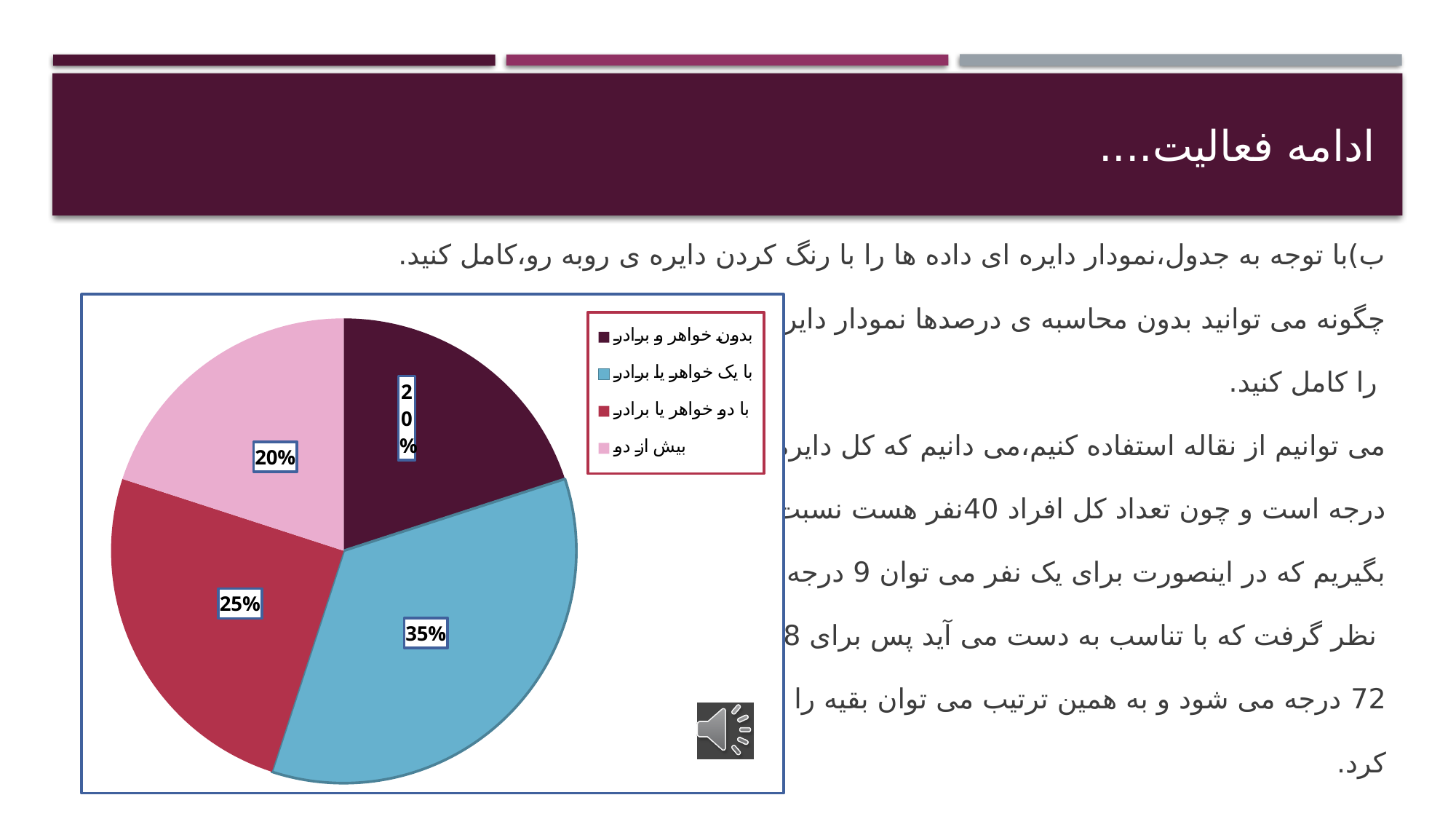
What percentage is shown for the slice labelled "بیش از دو"? 20% Which slice of the pie chart is the largest? با یک خواهر یا برادر What percentage is shown for the slice labelled "بدون خواهر و برادر"? 20% What percentage is shown for the slice labelled "با یک خواهر یا برادر"? 35% Which is larger, the "با دو خواهر یا برادر" slice or the "بیش از دو" slice? با دو خواهر یا برادر What colour is the slice labelled "با یک خواهر یا برادر" in the pie chart? light blue What kind of chart is shown on the slide? pie chart What percentage is shown for the slice labelled "با دو خواهر یا برادر"? 25% What is the difference in percentage points between the "با یک خواهر یا برادر" slice and the "با دو خواهر یا برادر" slice? 10 What is the combined share of the "بدون خواهر و برادر" and "بیش از دو" slices? 40% How many entries does the legend of the pie chart list? 4 How many slices does the pie chart have? 4